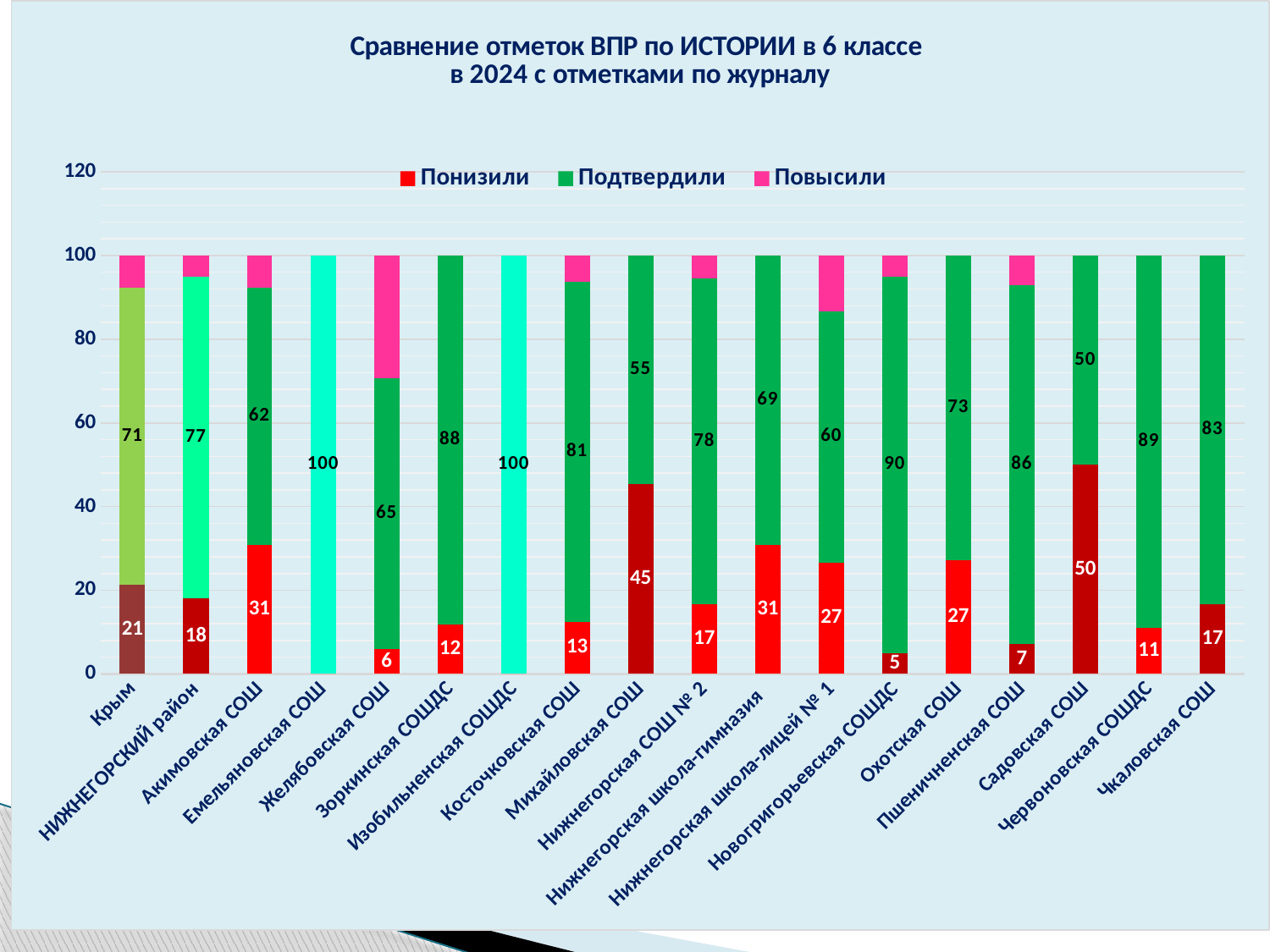
What is the value of Понизили for Крым? 21 What type of chart is shown on the slide? Stacked bar chart How many series does the legend list? 3 How many schools/categories are shown on the x axis? 18 What is the value of Подтвердили for Новогригорьевская СОШДС? 90 Which category has the highest value of Понизили? Садовская СОШ Which is larger: the Подтвердили value for Охотская СОШ or for Нижнегорская школа-лицей № 1? Охотская СОШ What is the difference between the Понизили values for Михайловская СОШ and Чкаловская СОШ? 28 Is the Повысили value for Желябовская СОШ greater or less than 20? greater Which category has the lowest value of Подтвердили? Садовская СОШ What is the value of Понизили for Михайловская СОШ? 45 What is the total of the stacked bar for Садовская СОШ? 100